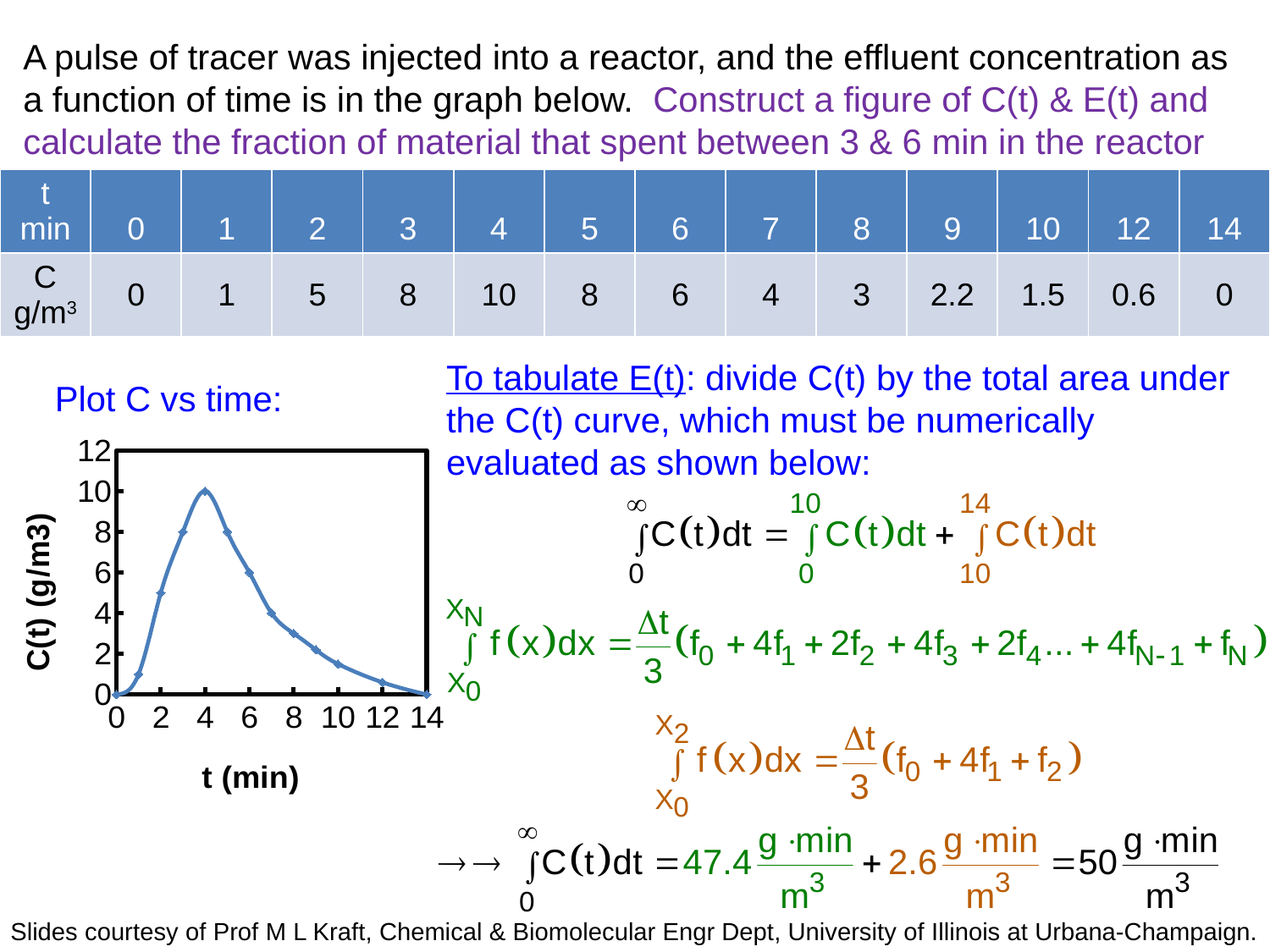
What is the label on the x axis of the C vs time chart? t (min) In the C vs time chart, what is the value of C(t) at t = 6 min? 6 In the C vs time chart, which is larger: C(t) at t = 3 min or at t = 7 min? t = 3 min How many data points are plotted in the C vs time chart? 13 In the C vs time chart, is the value of C(t) at t = 2 min greater or less than 4? greater In the C vs time chart, what is the value of C(t) at t = 4 min? 10 In the C vs time chart, at what time does C(t) reach its highest value? 4 min In the C vs time chart, what is the difference between C(t) at t = 4 min and at t = 6 min? 4 In the C vs time chart, do the values rise or fall between t = 4 min and t = 14 min? fall What kind of chart is the 'Plot C vs time' chart? line chart In the C vs time chart, what is the value of C(t) at t = 3 min? 8 In the C vs time chart, is the value of C(t) at t = 9 min greater or less than 4? less